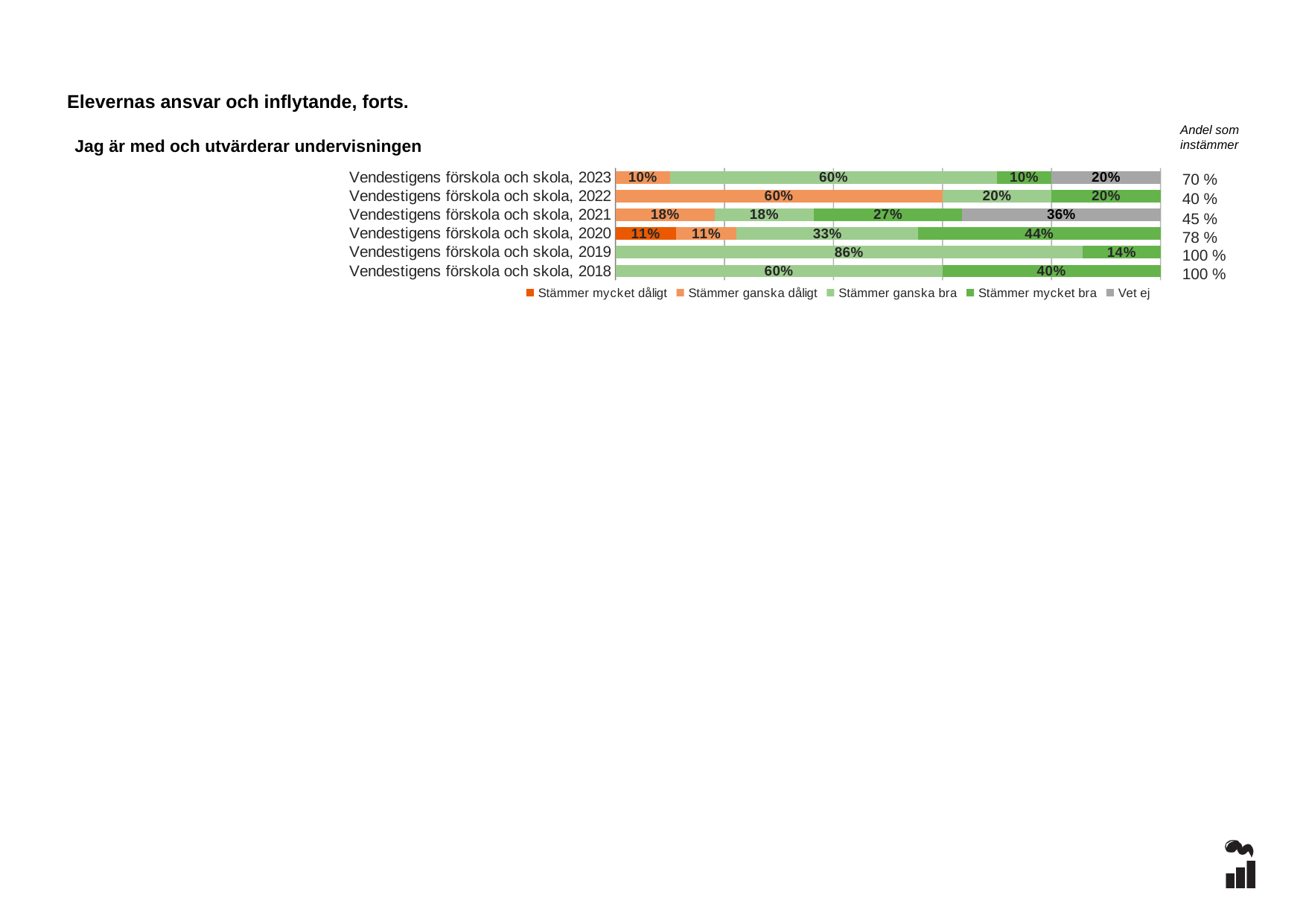
How many categories (bars) are plotted in the chart? 6 What is the total of the stacked bar for Vendestigens förskola och skola, 2023? 100% How many series does the legend list? 5 Which is larger: 'Stämmer ganska bra' for 2023 or 'Stämmer ganska bra' for 2021? 2023 What is the value of 'Stämmer mycket dåligt' for Vendestigens förskola och skola, 2020? 11% What kind of chart is shown on the slide? stacked bar chart What is the value of 'Stämmer ganska dåligt' for Vendestigens förskola och skola, 2022? 60% Which category has the highest value for 'Stämmer mycket bra'? Vendestigens förskola och skola, 2020 What is the difference between the 'Stämmer mycket bra' values for 2018 and 2023? 30% What is the value of 'Vet ej' for Vendestigens förskola och skola, 2021? 36% What is the 'Andel som instämmer' value shown for Vendestigens förskola och skola, 2020? 78 % What is the value of 'Stämmer ganska bra' for Vendestigens förskola och skola, 2019? 86%